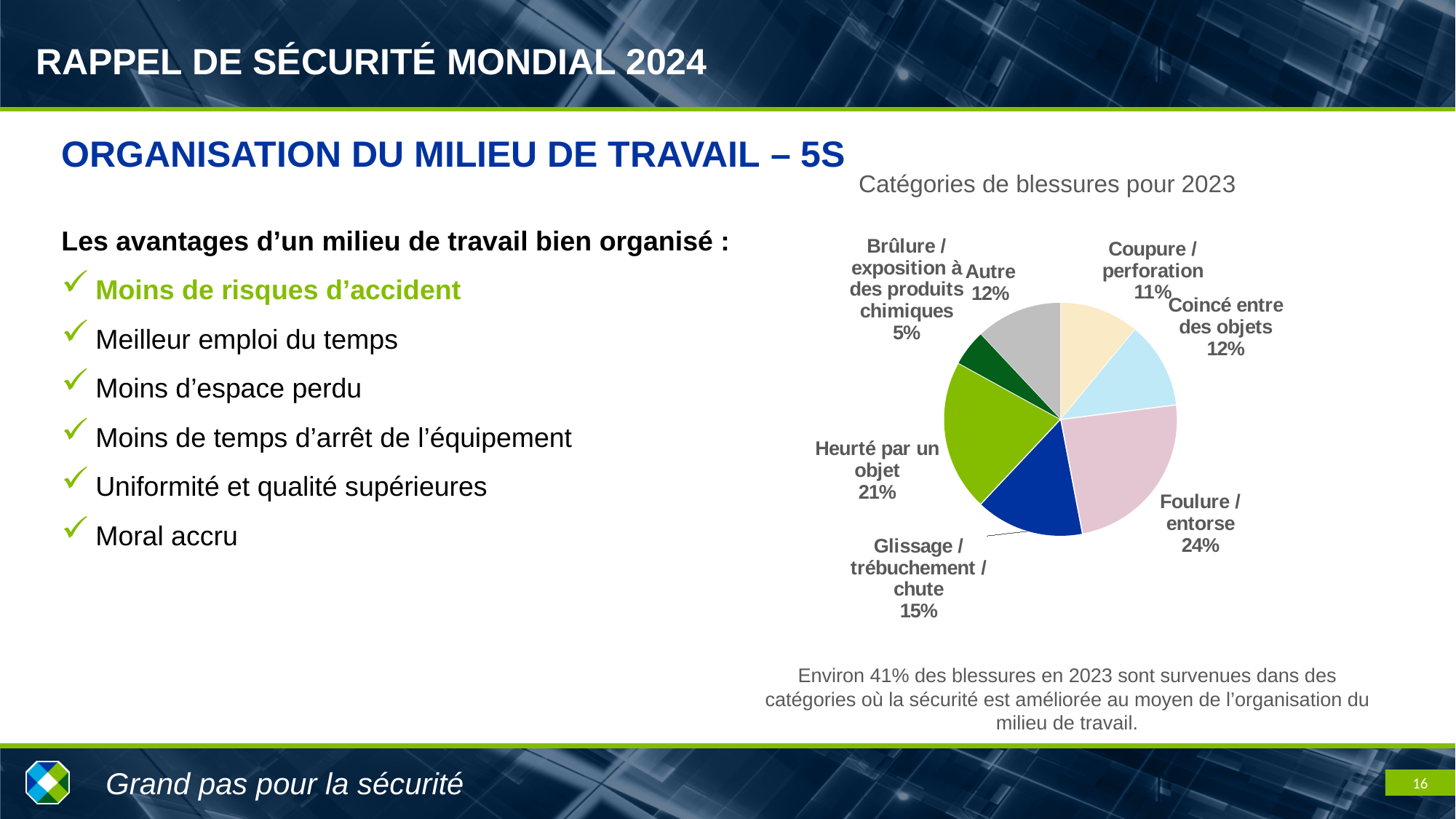
What kind of chart is shown on the slide? pie chart What is the difference in percentage points between Foulure / entorse and Glissage / trébuchement / chute? 9 Which category has the largest share of the pie? Foulure / entorse What is the title of the chart? Catégories de blessures pour 2023 Which is larger, the share for Heurté par un objet or the share for Coincé entre des objets? Heurté par un objet What share of injuries is attributed to Heurté par un objet? 21% Which category has the smallest share of the pie? Brûlure / exposition à des produits chimiques What share of injuries is attributed to Brûlure / exposition à des produits chimiques? 5% What share of injuries is attributed to Coupure / perforation? 11% How many categories does the pie chart show? 7